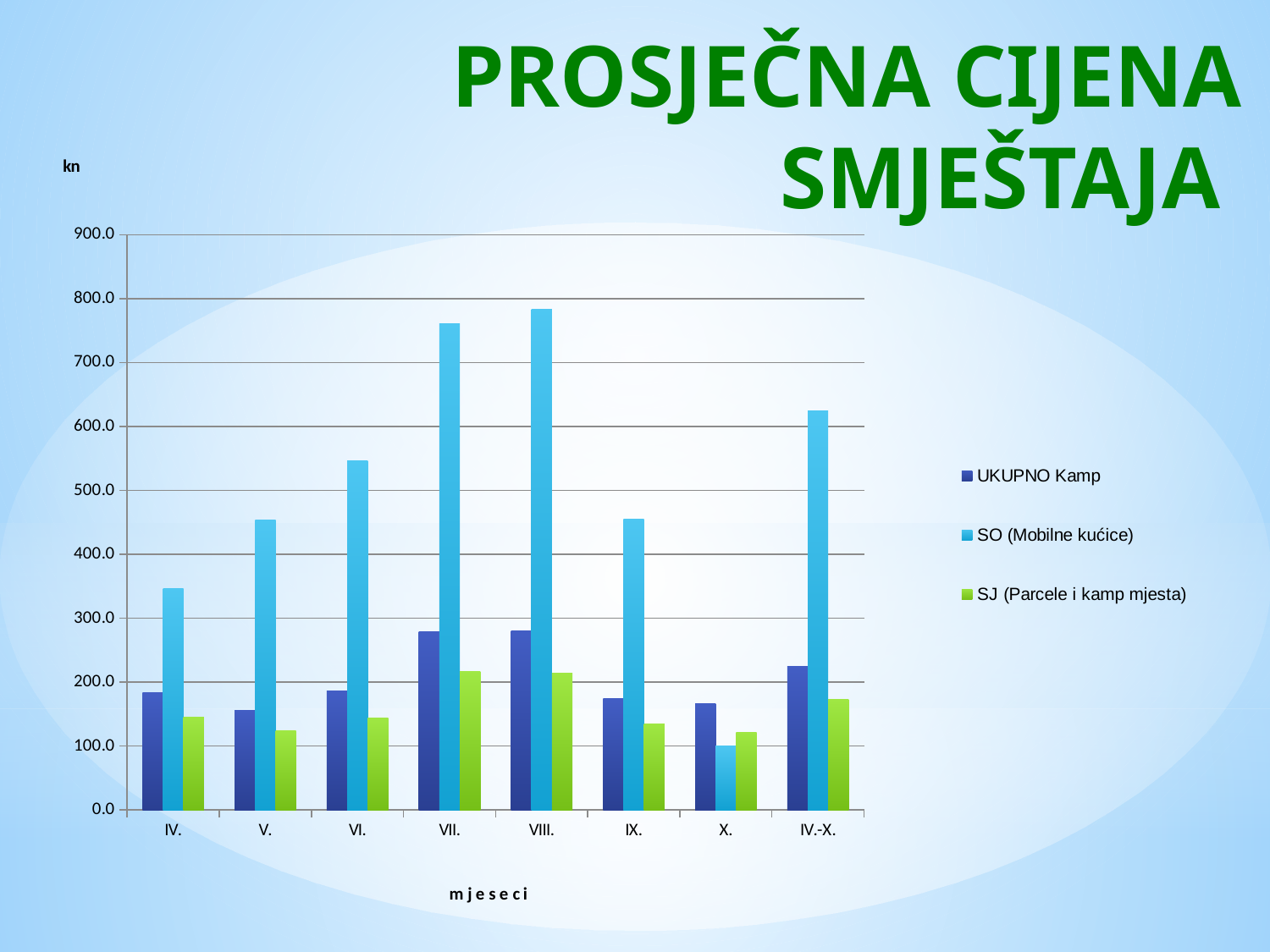
In X., which is larger: UKUPNO Kamp or SO (Mobilne kućice)? UKUPNO Kamp Is the value for UKUPNO Kamp in VII. greater or less than 200? greater How many categories are shown on the x axis? 8 Which category has the highest value for SO (Mobilne kućice)? VIII. Is the value for SO (Mobilne kućice) in VII. greater or less than 700? greater Is the value for SO (Mobilne kućice) in IV.-X. greater or less than 600? greater What is the label on the x axis of the chart? m j e s e c i Which category has the lowest value for SO (Mobilne kućice)? X. What kind of chart is shown on the slide? bar chart How many series does the legend list? 3 Do the values for SO (Mobilne kućice) rise or fall from IV. to VIII.? rise